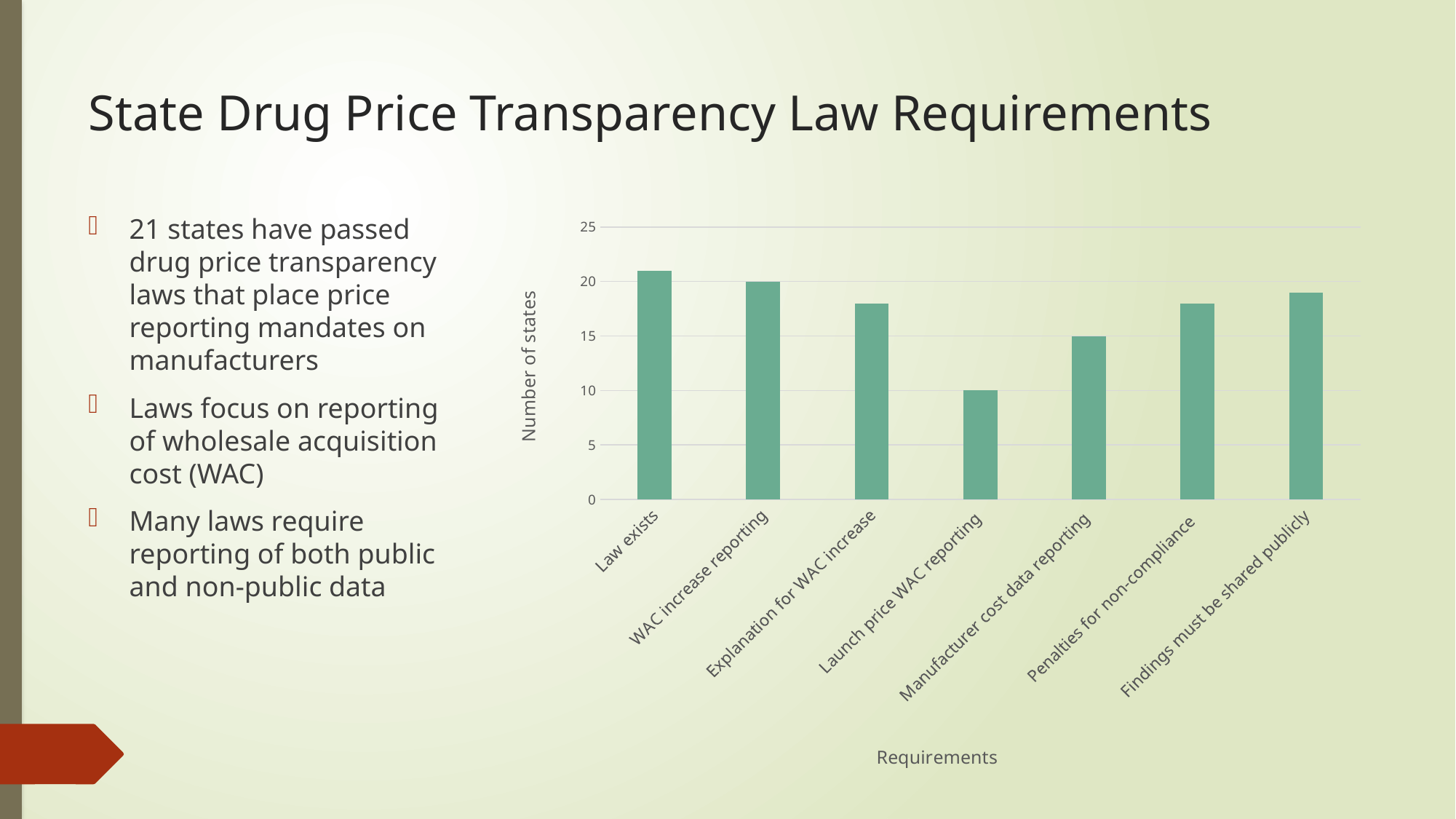
What is the difference in number of states between WAC increase reporting and Launch price WAC reporting? 10 How many requirement categories are plotted on the chart? 7 Which requirement has the lowest number of states? Launch price WAC reporting Is the value for Findings must be shared publicly greater or less than 15? greater Is the value for Penalties for non-compliance greater or less than 20? less What type of chart is shown on the slide? Bar chart Which has more states: Manufacturer cost data reporting or Launch price WAC reporting? Manufacturer cost data reporting What is the label of the vertical axis? Number of states What is the number of states for WAC increase reporting? 20 What is the label of the horizontal axis? Requirements What is the number of states for Launch price WAC reporting? 10 What is the number of states for Manufacturer cost data reporting? 15